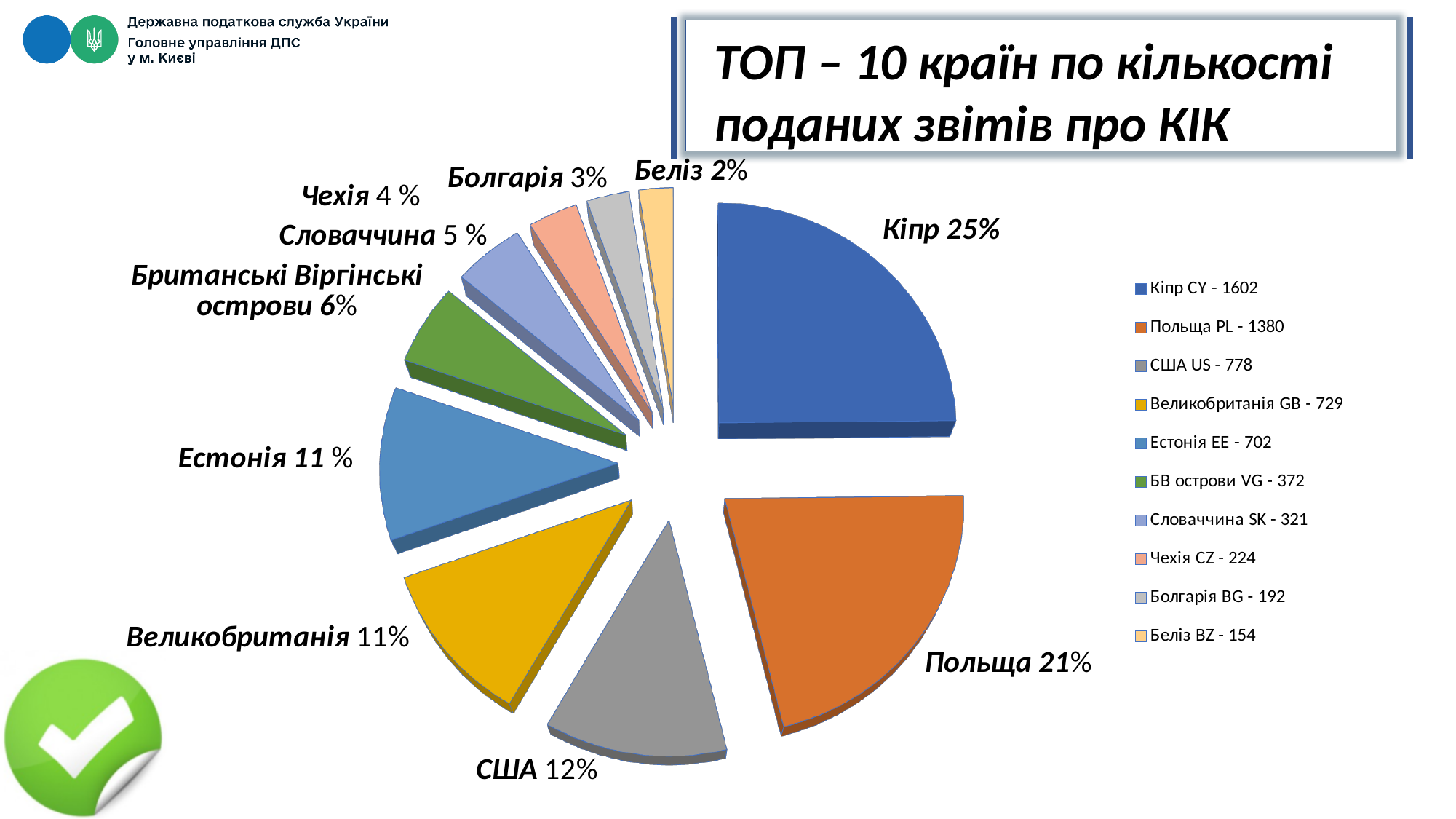
What share of the pie do the Британські Віргінські острови (British Virgin Islands) hold? 6% Which has a larger value, Словаччина SK or Чехія CZ? Словаччина SK Which country has the smallest slice of the pie? Беліз What share of the pie does Польща (Poland) hold? 21% What is the number of reports for Естонія EE shown in the legend? 702 Which country has the largest slice of the pie? Кіпр How many countries (slices) does the pie chart show? 10 What is the number of reports for Беліз BZ shown in the legend? 154 What kind of chart is shown on the slide? pie chart What is the number of reports for США US shown in the legend? 778 What is the difference between the values for Кіпр CY and Польща PL in the legend? 222 What share of the pie does Кіпр (Cyprus) hold? 25%